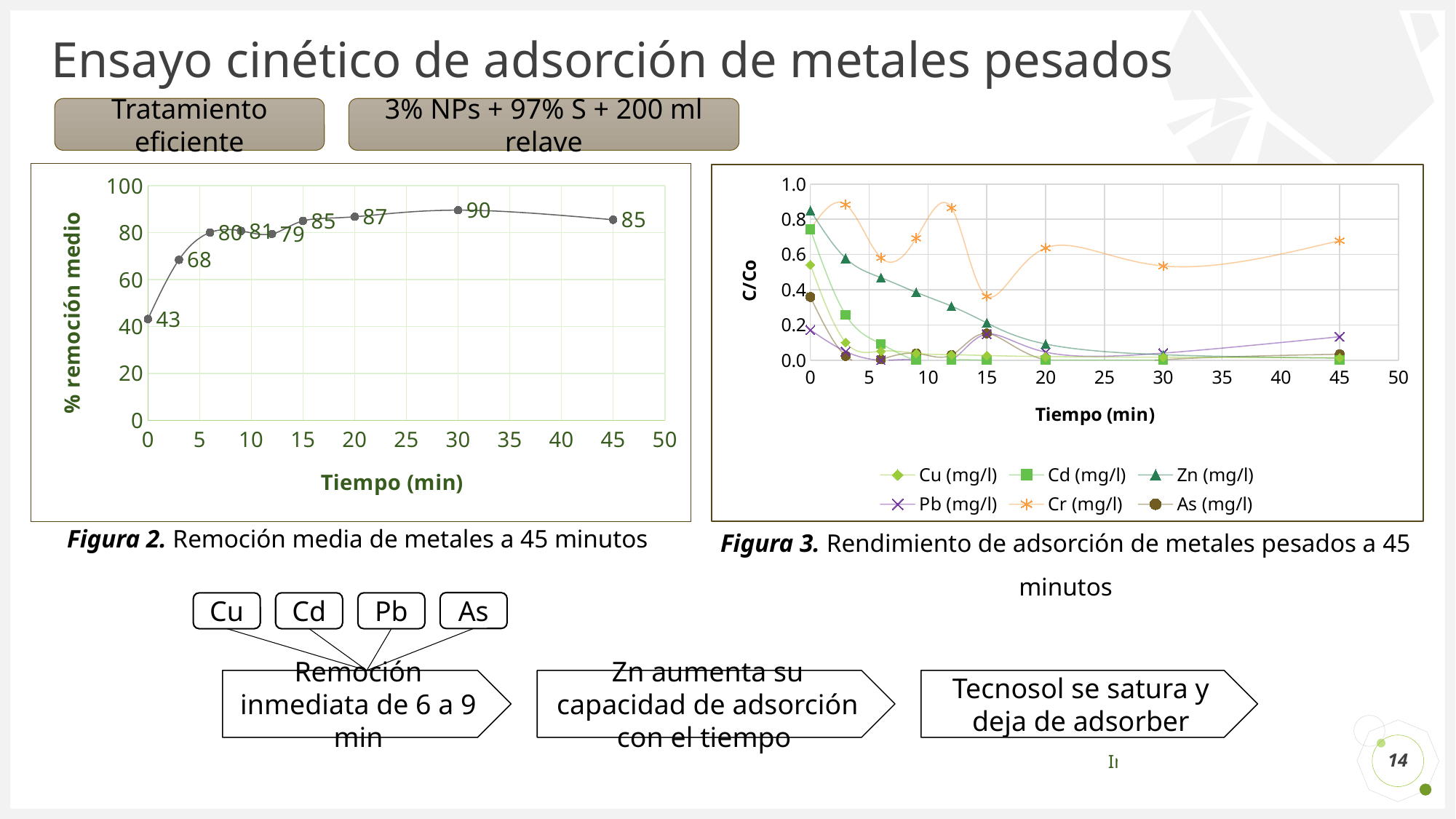
In Figura 2 (left chart), how many data points are plotted? 9 In Figura 2 (left chart), what is the % remoción medio at 0 minutes? 43 In Figura 3 (right chart), is the C/Co value for Cr (mg/l) at 3 minutes greater or less than 0.8? greater In Figura 3 (right chart), how many series does the legend list? 6 In Figura 2 (left chart), what is the % remoción medio at 30 minutes? 90 What kind of chart is Figura 3 (right chart)? line chart In Figura 2 (left chart), what is the % remoción medio at 45 minutes? 85 In Figura 2 (left chart), what is the difference between the % remoción medio at 3 minutes and at 0 minutes? 25 In Figura 2 (left chart), at which time is the % remoción medio highest? 30 min In Figura 2 (left chart), which is larger: the value at 12 minutes or the value at 15 minutes? 15 minutes In Figura 2 (left chart), at which time is the % remoción medio lowest? 0 min In Figura 3 (right chart), is the C/Co value for Zn (mg/l) at 45 minutes greater or less than 0.2? less